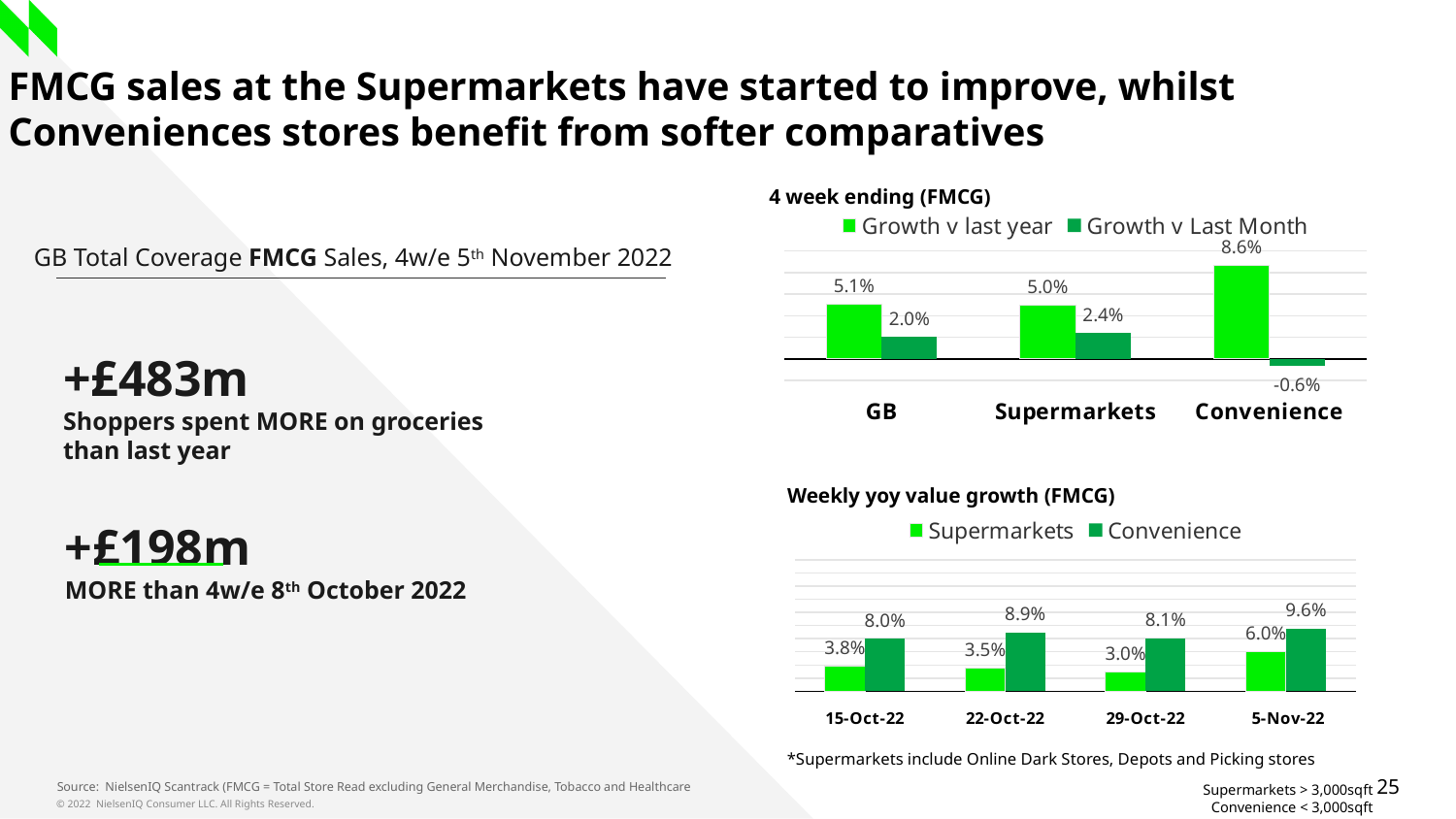
In the '4 week ending (FMCG)' chart, which category has the lowest Growth v Last Month value? Convenience In the 'Weekly yoy value growth (FMCG)' chart, what is the Supermarkets value for 5-Nov-22? 6.0% In the '4 week ending (FMCG)' chart, how many series does the legend list? 2 In the 'Weekly yoy value growth (FMCG)' chart, what is the difference between the Convenience and Supermarkets values for 15-Oct-22? 4.2% In the 'Weekly yoy value growth (FMCG)' chart, how many weeks are shown on the x axis? 4 In the 'Weekly yoy value growth (FMCG)' chart, what is the Convenience value for 22-Oct-22? 8.9% In the '4 week ending (FMCG)' chart, what is the Growth v Last Month value for Supermarkets? 2.4% What type of chart is the 'Weekly yoy value growth (FMCG)' chart? bar chart In the 'Weekly yoy value growth (FMCG)' chart, which week has the lowest Supermarkets value? 29-Oct-22 In the '4 week ending (FMCG)' chart, what is the difference between the Growth v last year values for Convenience and GB? 3.5% In the '4 week ending (FMCG)' chart, is the Growth v Last Month value for GB larger or smaller than that for Supermarkets? smaller In the '4 week ending (FMCG)' chart, what is the Growth v last year value for Convenience? 8.6%